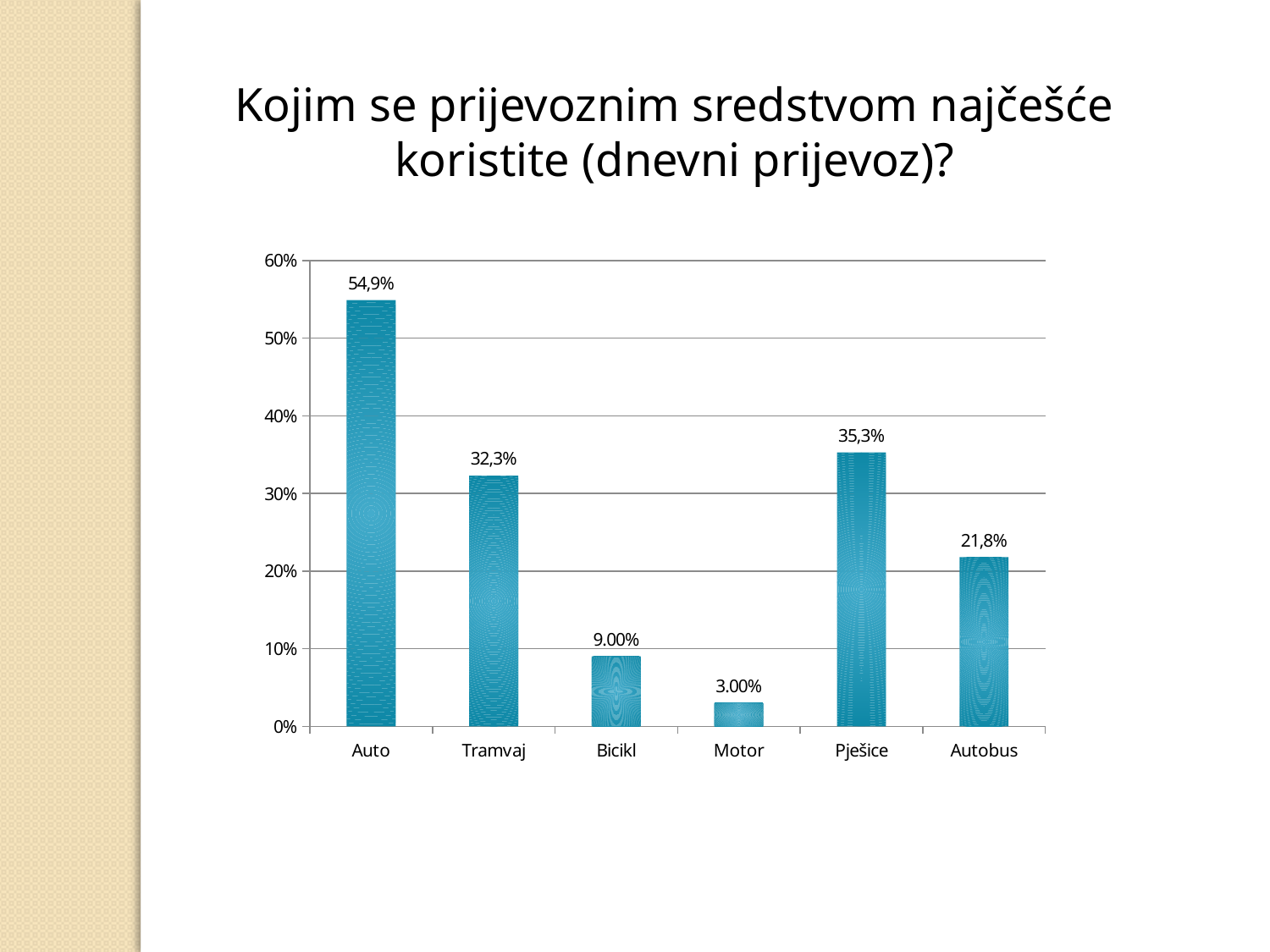
What is the value for Auto? 54,9% How many categories are shown on the x axis? 6 What kind of chart is shown on the slide? bar chart What is the value for Pješice? 35,3% What is the value for Autobus? 21,8% What is the value for Motor? 3.00% What is the title of the slide? Kojim se prijevoznim sredstvom najčešće koristite (dnevni prijevoz)? What is the difference between the values for Auto and Tramvaj? 22,6% Is the value for Bicikl greater or less than 10%? less Which category has the lowest value? Motor Which category has the highest value? Auto Which is larger, the value for Pješice or the value for Tramvaj? Pješice